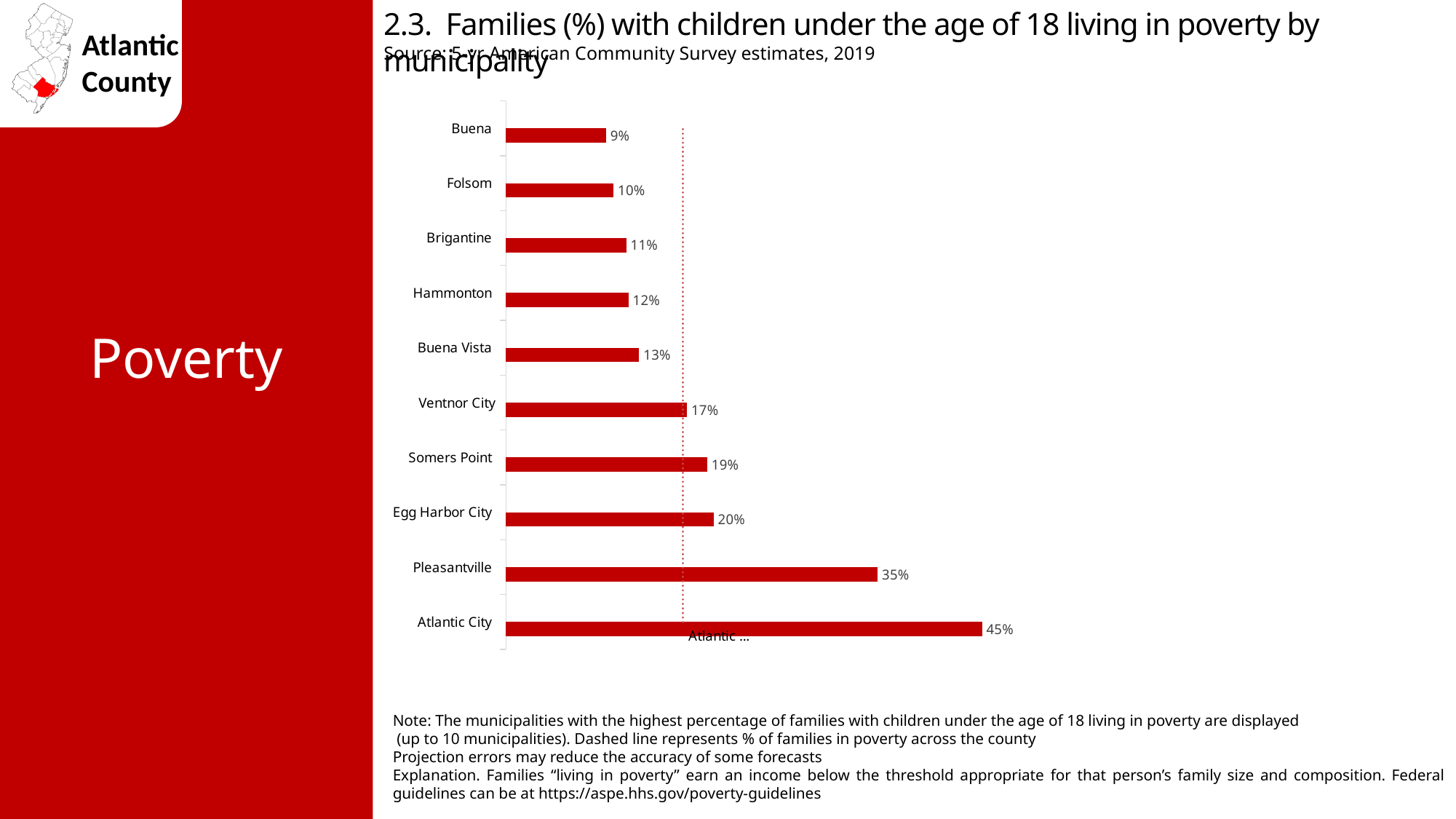
What is the difference between the values for Egg Harbor City and Folsom? 10% How many municipalities are shown on the chart? 10 What is the value shown for Pleasantville? 35% What percentage of families with children under 18 are living in poverty in Atlantic City? 45% What does the dashed vertical line on the chart represent? % of families in poverty across the county Which municipality has the highest percentage of families with children under 18 living in poverty? Atlantic City What is the difference between the values for Atlantic City and Pleasantville? 10% Which municipality has the lowest percentage shown on the chart? Buena What is the value shown for Hammonton? 12% What is the value shown for Somers Point? 19% Which has a higher value, Ventnor City or Buena Vista? Ventnor City What kind of chart is shown on the slide? Bar chart